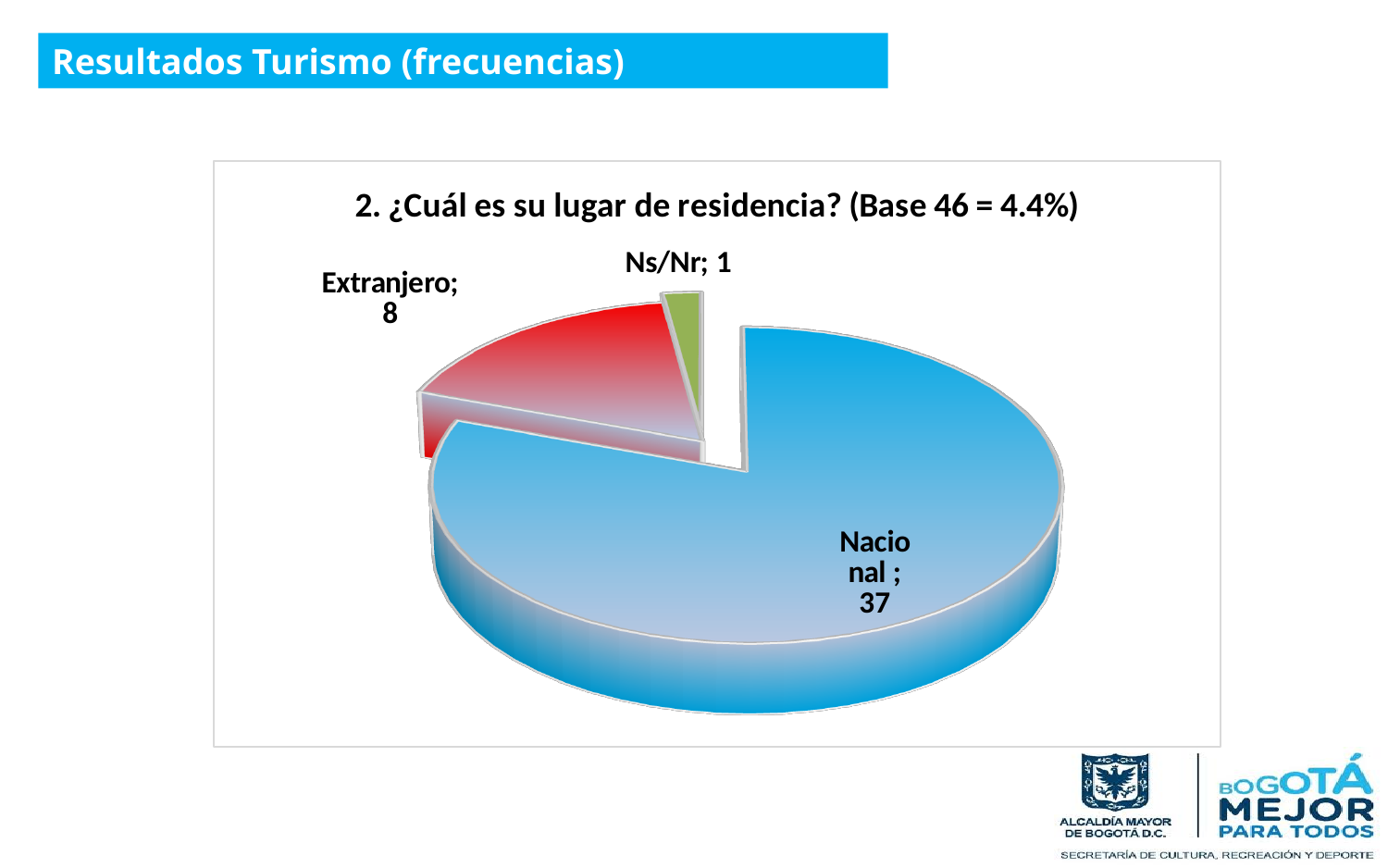
What is the value for Extranjero? 8 What is the difference between the values for Extranjero and Ns/Nr? 7 Which category has the largest slice of the pie? Nacional Which is larger, the value for Extranjero or the value for Ns/Nr? Extranjero How many categories are shown in the pie chart? 3 What is the total of all the slices in the pie chart? 46 Which category has the smallest slice of the pie? Ns/Nr What is the title of the chart? 2. ¿Cuál es su lugar de residencia? (Base 46 = 4.4%) What is the value for Nacional? 37 What is the difference between the values for Nacional and Extranjero? 29 What is the value for Ns/Nr? 1 What type of chart is shown on the slide? Pie chart